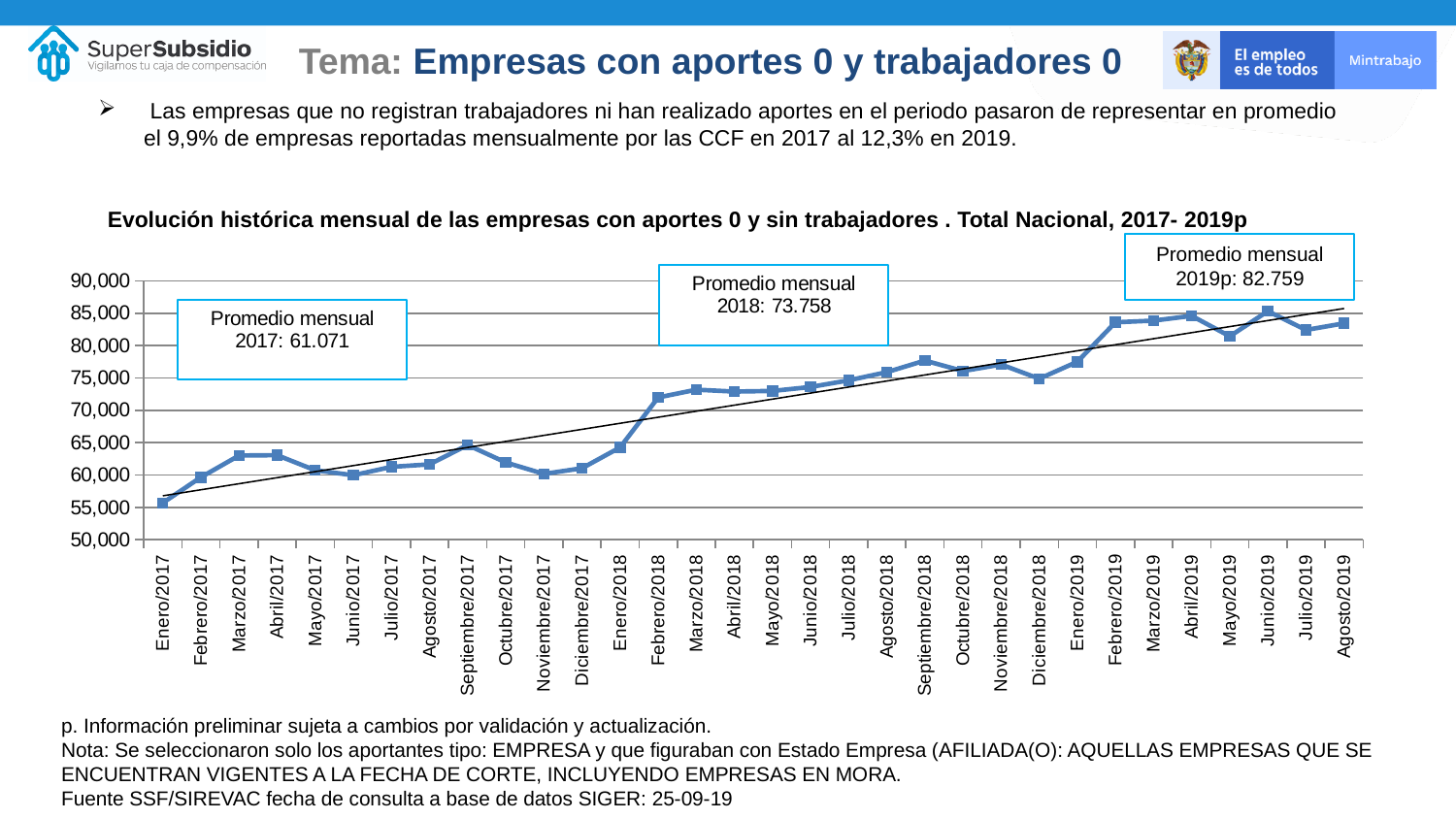
Which month has the lowest value on the chart? Enero/2017 Which month has the highest value on the chart? Junio/2019 Overall, do the values rise or fall from Enero/2017 to Agosto/2019? Rise Which is larger, the value for Septiembre/2017 or the value for Noviembre/2017? Septiembre/2017 How many monthly data points are plotted on the chart? 32 Is the value for Enero/2017 greater or less than 60,000? less What is the monthly average (promedio mensual) shown for 2019p? 82.759 What is the monthly average (promedio mensual) shown for 2017? 61.071 By how much does the 2018 monthly average exceed the 2017 monthly average? 12.687 Is the value for Septiembre/2018 greater or less than 75,000? greater What kind of chart is shown on the slide? Line chart What is the monthly average (promedio mensual) shown for 2018? 73.758